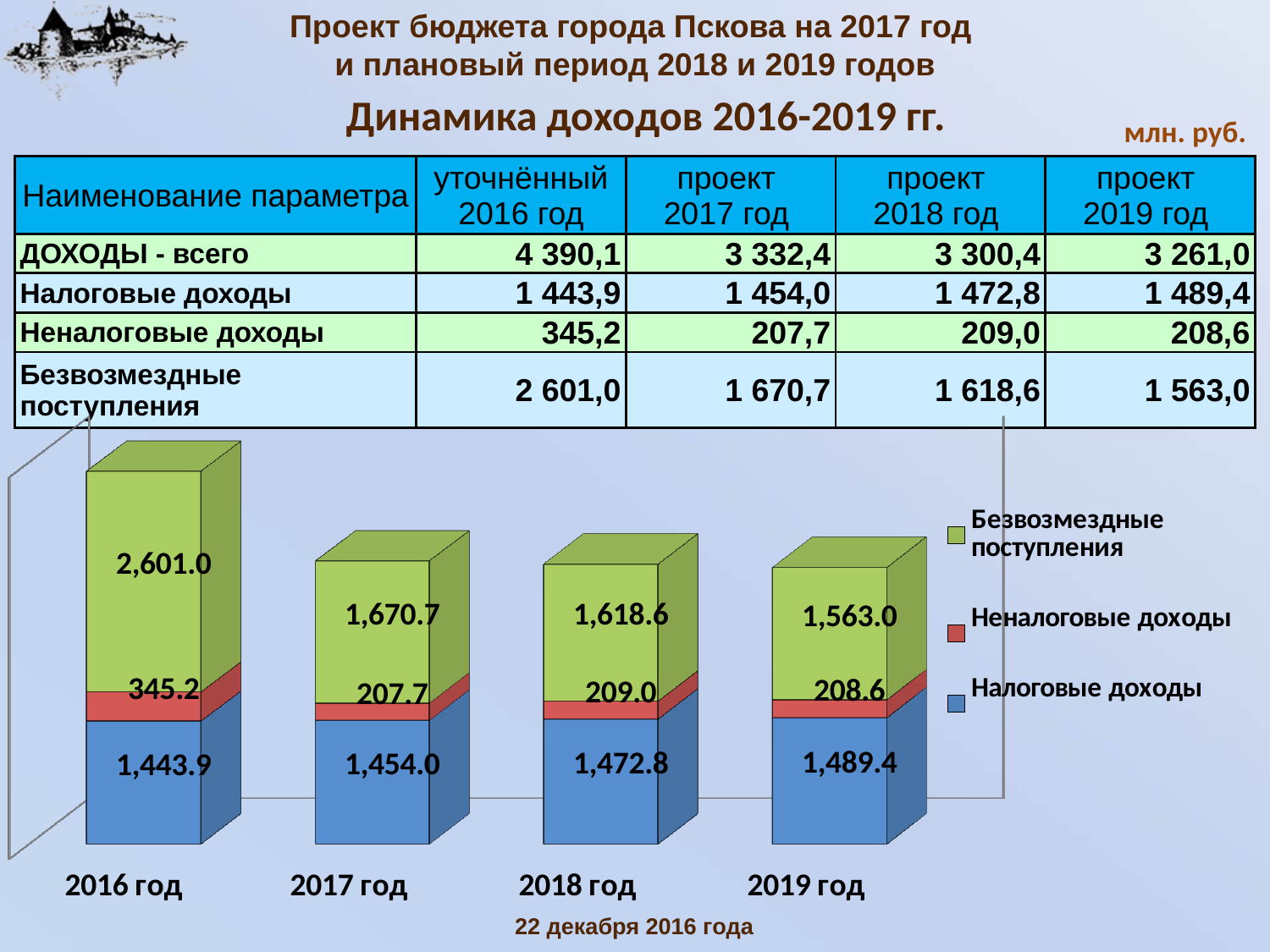
In which year is Безвозмездные поступления highest in the chart? 2016 год What is the value of Неналоговые доходы for 2017 год in the chart? 207.7 Which is larger: Налоговые доходы in 2018 год or in 2017 год? 2018 год Does Налоговые доходы rise or fall from 2016 год to 2019 год? Rise What is the difference between Безвозмездные поступления in 2016 год and 2017 год? 930.3 In which year is Неналоговые доходы lowest in the chart? 2017 год What is the value of Налоговые доходы for 2019 год in the chart? 1,489.4 What kind of chart is shown on the slide? Stacked bar chart What is the value of Безвозмездные поступления for 2016 год in the chart? 2,601.0 What is the total of the stacked bar for 2019 год? 3,261.0 How many years (categories) are shown on the x axis of the chart? 4 How many series does the chart legend list? 3